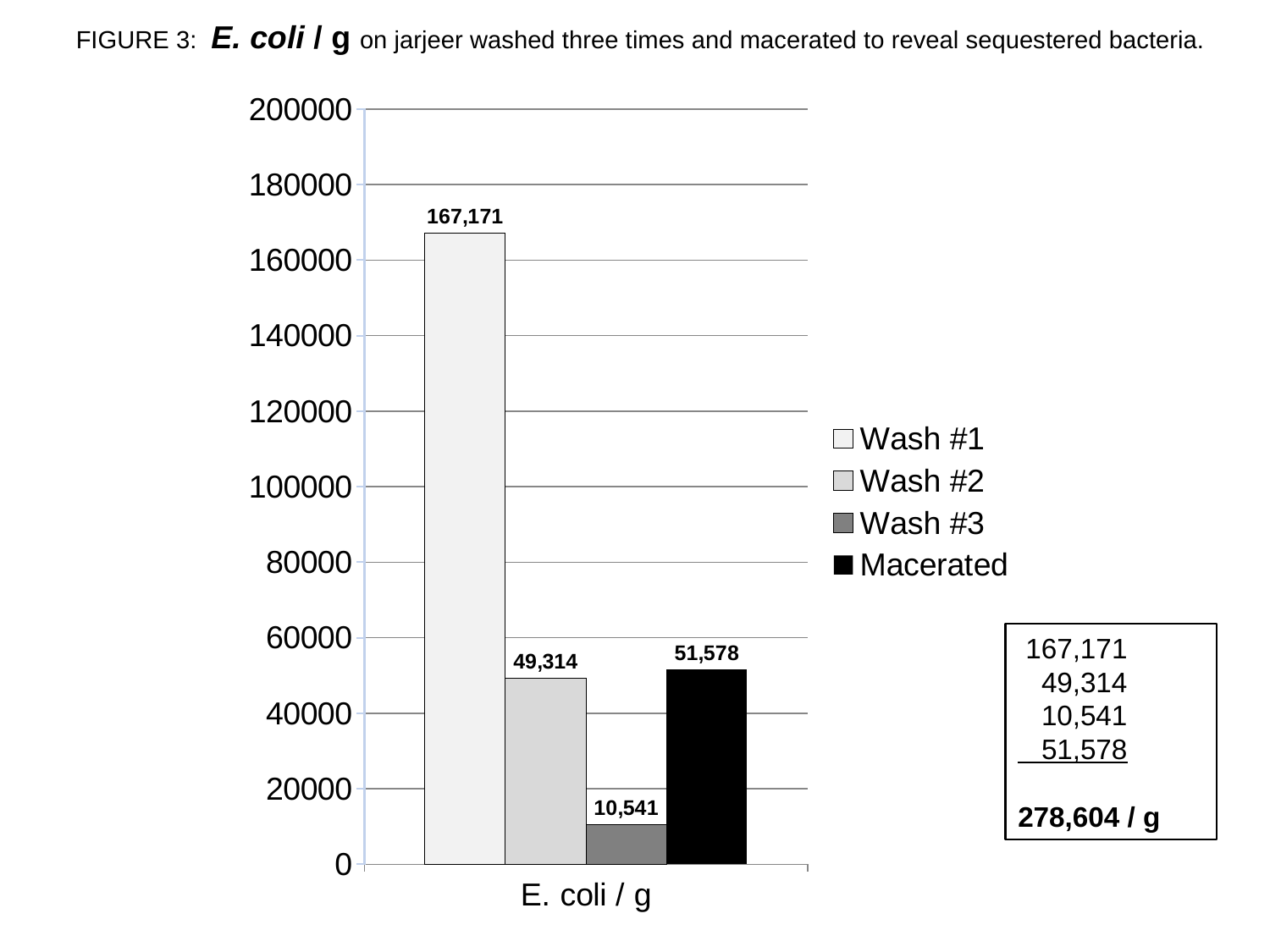
How many series does the legend list? 4 What kind of chart is shown on the slide? Bar chart What is the difference between the values for Wash #1 and Wash #2? 117,857 Which series has the lowest value? Wash #3 What is the difference between the values for Macerated and Wash #3? 41,037 What is the total of the four values shown in the box on the right of the slide? 278,604 / g What is the value for Wash #1? 167,171 What is the value for Macerated? 51,578 What is the value for Wash #2? 49,314 Which is larger, the value for Wash #2 or the value for Macerated? Macerated What is the value for Wash #3? 10,541 Which series has the highest value? Wash #1